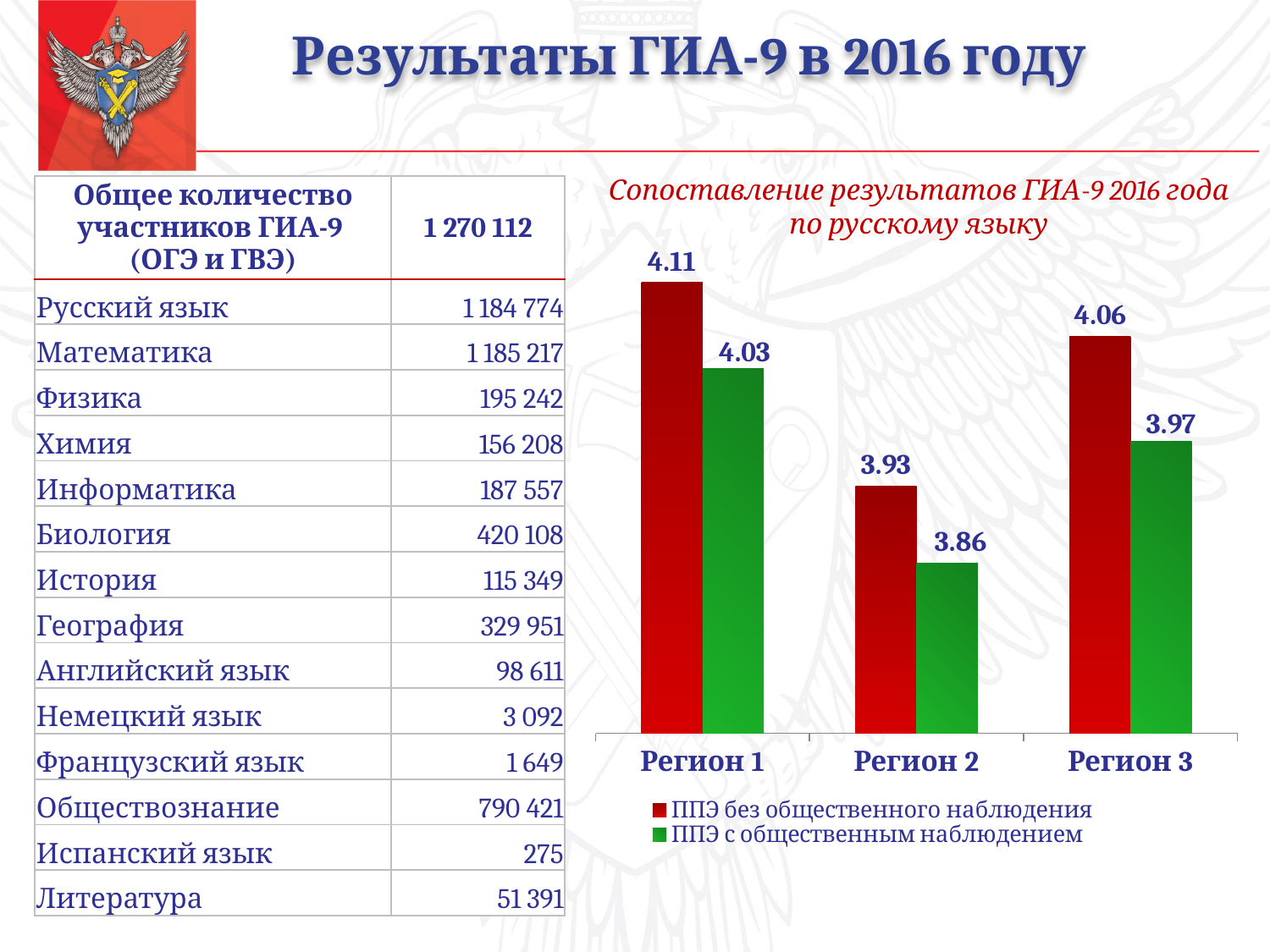
What kind of chart is shown on the slide? bar chart What is the value for Регион 1 in the series ППЭ без общественного наблюдения? 4.11 Which is larger for Регион 2: ППЭ без общественного наблюдения or ППЭ с общественным наблюдением? ППЭ без общественного наблюдения What colour are the bars for ППЭ с общественным наблюдением? green Which region has the lowest value in the series ППЭ с общественным наблюдением? Регион 2 What is the value for Регион 3 in the series ППЭ без общественного наблюдения? 4.06 Which region has the highest value in the series ППЭ без общественного наблюдения? Регион 1 What is the difference between the two series for Регион 3? 0.09 How many series does the legend list? 2 What is the value for Регион 2 in the series ППЭ с общественным наблюдением? 3.86 How many regions are shown on the chart? 3 What is the difference between Регион 1 and Регион 2 in the series ППЭ без общественного наблюдения? 0.18